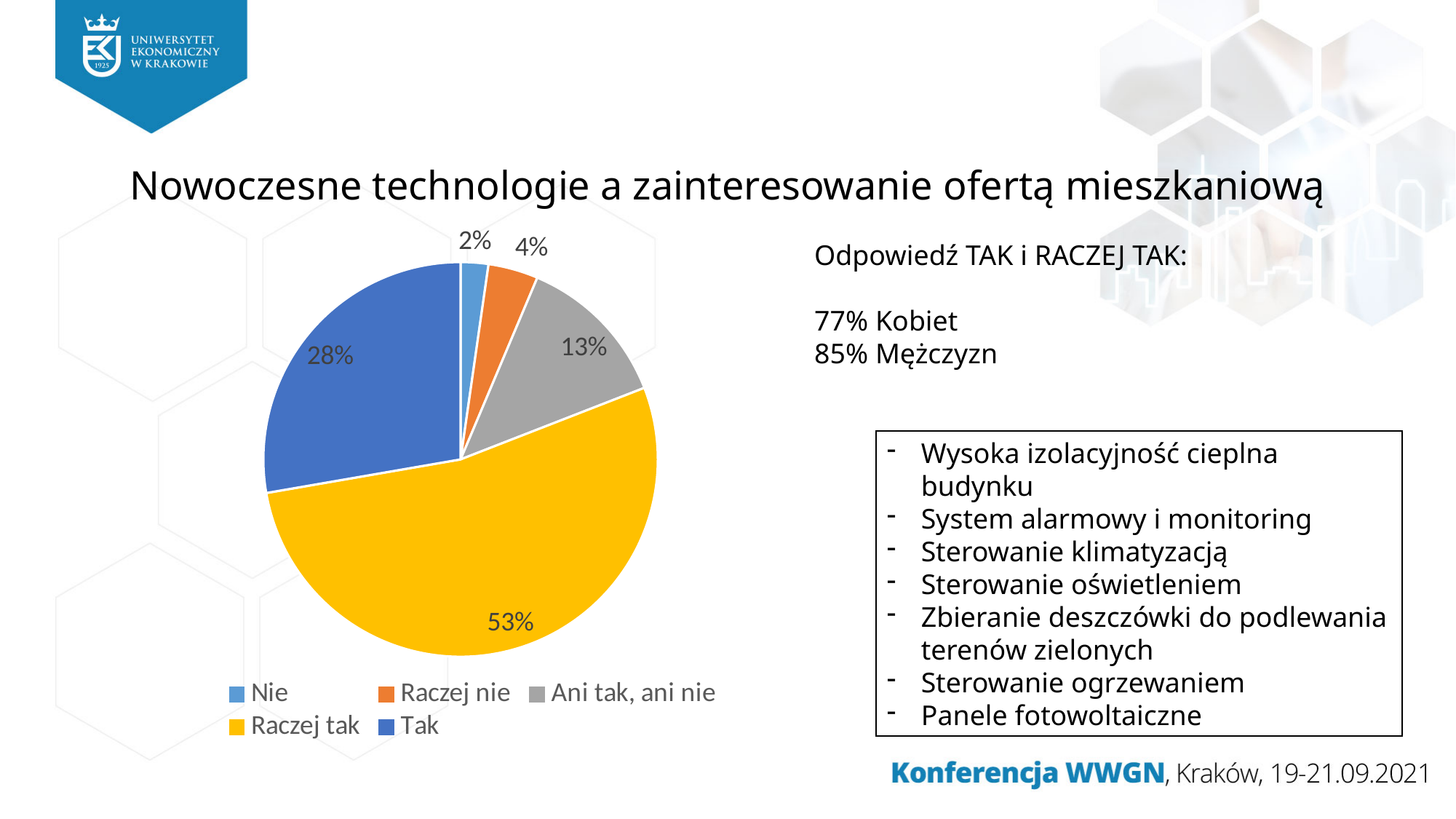
What is the value for 'Nie'? 2% What kind of chart is shown on the slide? pie chart What is the value for 'Ani tak, ani nie'? 13% What is the value for 'Raczej nie'? 4% Which category has the smallest slice of the pie? Nie What share of the pie does 'Raczej tak' have? 53% What is the difference between the 'Raczej tak' and 'Tak' slices? 25% How many categories does the pie chart have? 5 Which category has the largest slice of the pie? Raczej tak Which is larger, 'Ani tak, ani nie' or 'Raczej nie'? Ani tak, ani nie What share of the pie does 'Tak' have? 28% What colour is the 'Raczej tak' slice? yellow